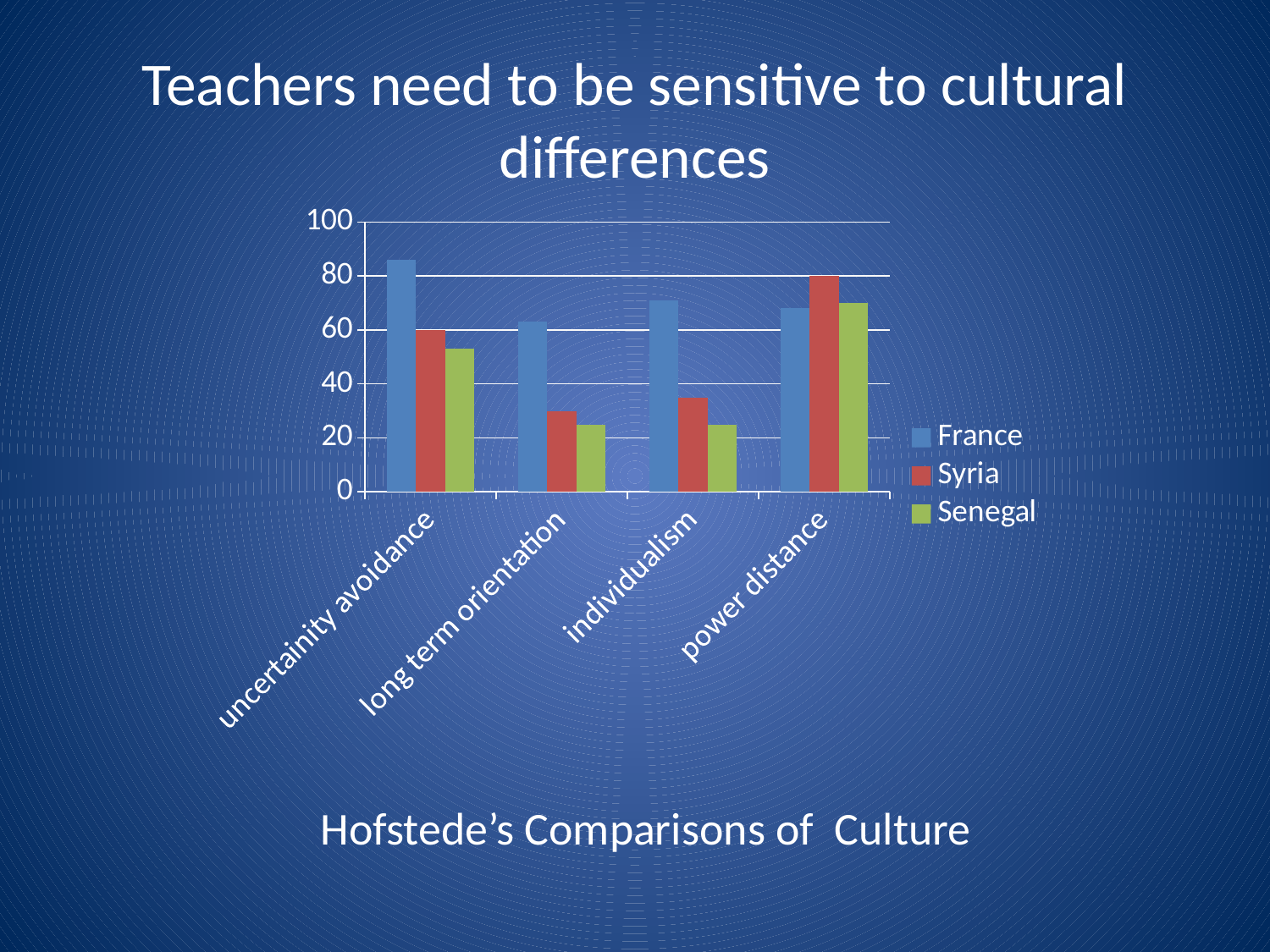
Which country has the highest value for uncertainity avoidance? France Is the value for Senegal in individualism greater or less than 40? less Is the value for Syria in long term orientation greater or less than 40? less Which country has the lowest value for individualism? Senegal What colour represents Senegal in the chart legend? green What kind of chart is shown on the slide? bar chart Is the value for France in uncertainity avoidance greater or less than 80? greater For individualism, which is larger: the value for France or the value for Syria? France For power distance, which is larger: the value for Syria or the value for France? Syria How many categories are shown on the x axis of the chart? 4 How many series does the legend list? 3